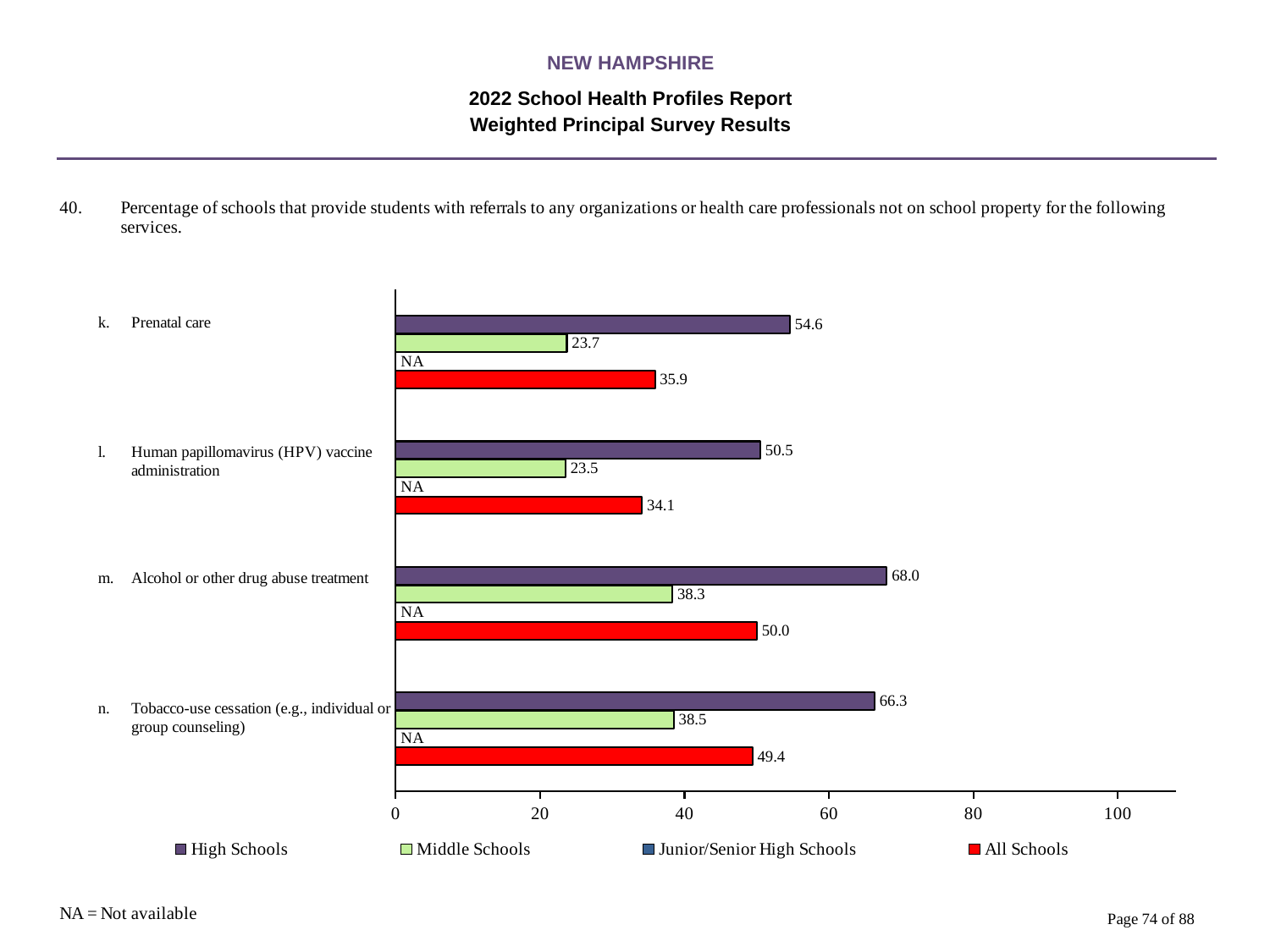
How many services (categories) are shown on the chart? 4 What is the High Schools value for Prenatal care? 54.6 What is the All Schools value for Alcohol or other drug abuse treatment? 50.0 Which service has the lowest All Schools value? Human papillomavirus (HPV) vaccine administration How many series does the legend list? 4 Which is larger: the All Schools value for Tobacco-use cessation or the All Schools value for Prenatal care? Tobacco-use cessation What is the Middle Schools value for Tobacco-use cessation (e.g., individual or group counseling)? 38.5 What is the difference between the High Schools and Middle Schools values for Prenatal care? 30.9 What kind of chart is shown on the slide? Bar chart What value is shown for Junior/Senior High Schools for each service? NA What is the Middle Schools value for Human papillomavirus (HPV) vaccine administration? 23.5 Which service has the highest High Schools value? Alcohol or other drug abuse treatment